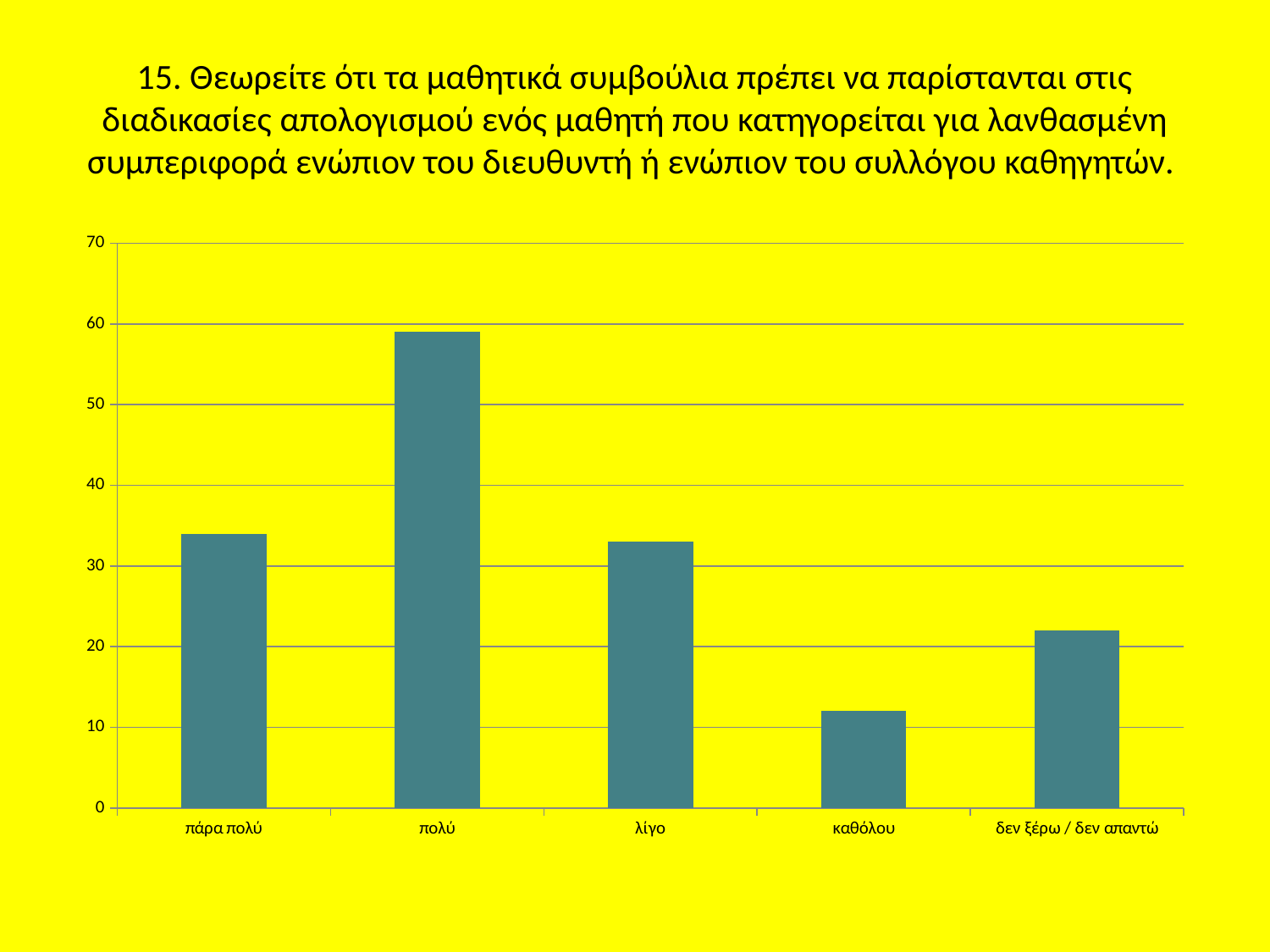
Which is larger, the value for πολύ or the value for λίγο? πολύ Is the value for πολύ greater or less than 50? greater Is the value for λίγο greater or less than 40? less What kind of chart is shown on the slide? bar chart How many categories are shown on the x axis of the chart? 5 Is the value for δεν ξέρω / δεν απαντώ greater or less than 30? less What is the highest value shown on the y axis of the chart? 70 Which is larger, the value for καθόλου or the value for δεν ξέρω / δεν απαντώ? δεν ξέρω / δεν απαντώ Which category has the lowest bar? καθόλου Which category has the highest bar? πολύ